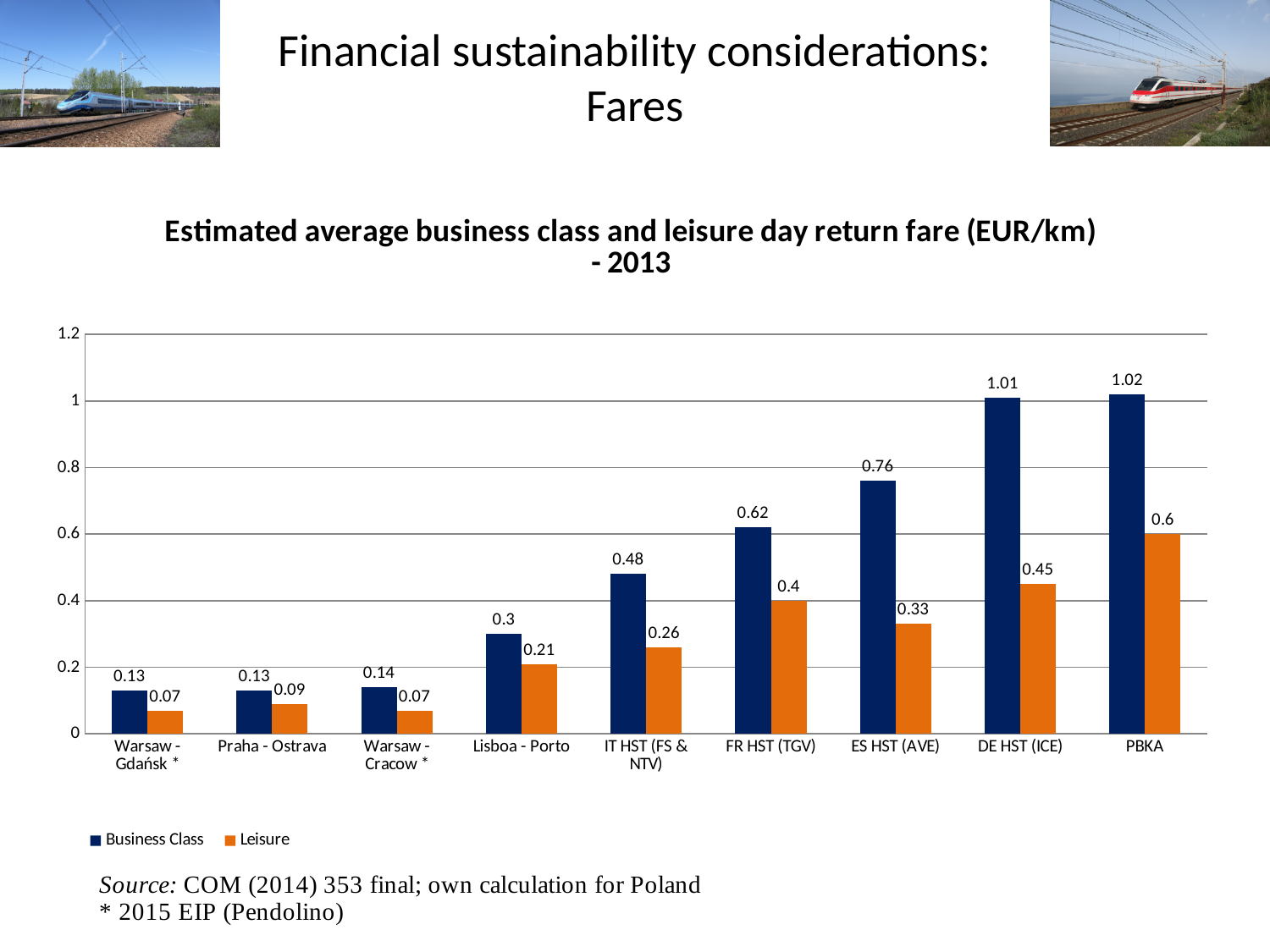
What is the Leisure fare for FR HST (TGV)? 0.4 How many series does the legend list? 2 Do the Business Class fares generally rise or fall from left to right along the x axis? Rise Which category has the highest Business Class fare? PBKA Which is larger: the Leisure fare for PBKA or the Business Class fare for IT HST (FS & NTV)? Leisure fare for PBKA What colour are the Leisure bars? Orange How many categories are shown on the x axis? 9 What is the difference between the Business Class and Leisure fares for ES HST (AVE)? 0.43 Is the Business Class fare for FR HST (TGV) greater or less than 0.6? greater Which category has the lowest Leisure fare? Warsaw - Gdańsk * and Warsaw - Cracow * (both 0.07) What kind of chart is shown on the slide? Bar chart What is the Business Class fare for DE HST (ICE)? 1.01